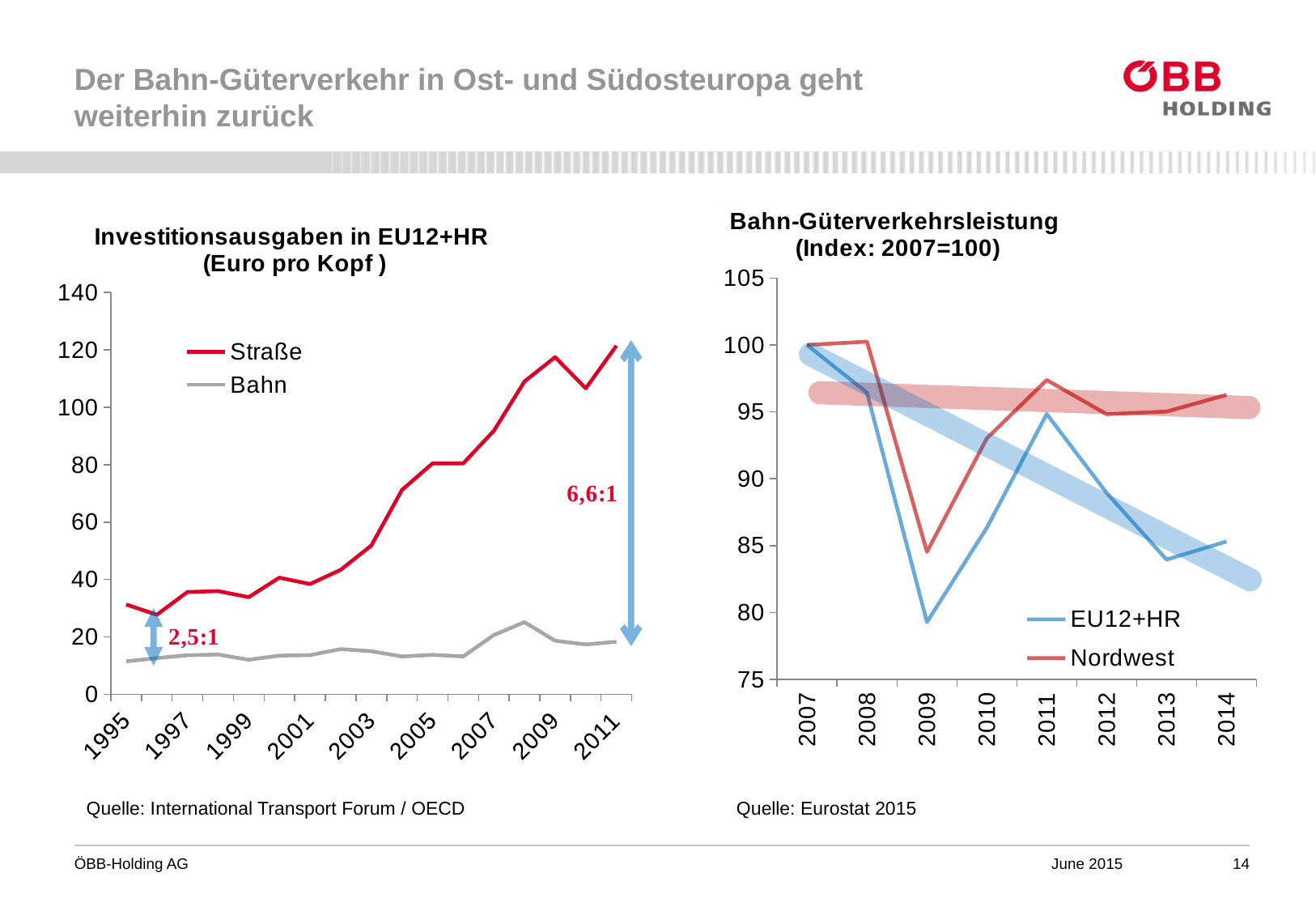
What kind of chart is the left chart titled "Investitionsausgaben in EU12+HR (Euro pro Kopf)"? line chart In the right chart (Bahn-Güterverkehrsleistung), which series is lower in 2009, EU12+HR or Nordwest? EU12+HR In the left chart (Investitionsausgaben in EU12+HR), is the value for Straße in 2009 greater or less than 100? greater In the left chart (Investitionsausgaben in EU12+HR), is the value for Bahn in 2011 greater or less than 40? less In the right chart (Bahn-Güterverkehrsleistung), in which year does the EU12+HR series reach its lowest value? 2009 In the right chart (Bahn-Güterverkehrsleistung), is the value for Nordwest in 2014 greater or less than 90? greater In the right chart (Bahn-Güterverkehrsleistung), what is the index value for EU12+HR in 2007? 100 How many series does the legend of the left chart (Investitionsausgaben in EU12+HR) list? 2 How many years are labelled on the x axis of the right chart (Bahn-Güterverkehrsleistung)? 8 In the left chart (Investitionsausgaben in EU12+HR), which series is higher in 2011, Straße or Bahn? Straße In the left chart (Investitionsausgaben in EU12+HR), what ratio is annotated next to the arrow at 2011? 6,6:1 In the left chart (Investitionsausgaben in EU12+HR), does the Straße series generally rise or fall from 1995 to 2011? rise